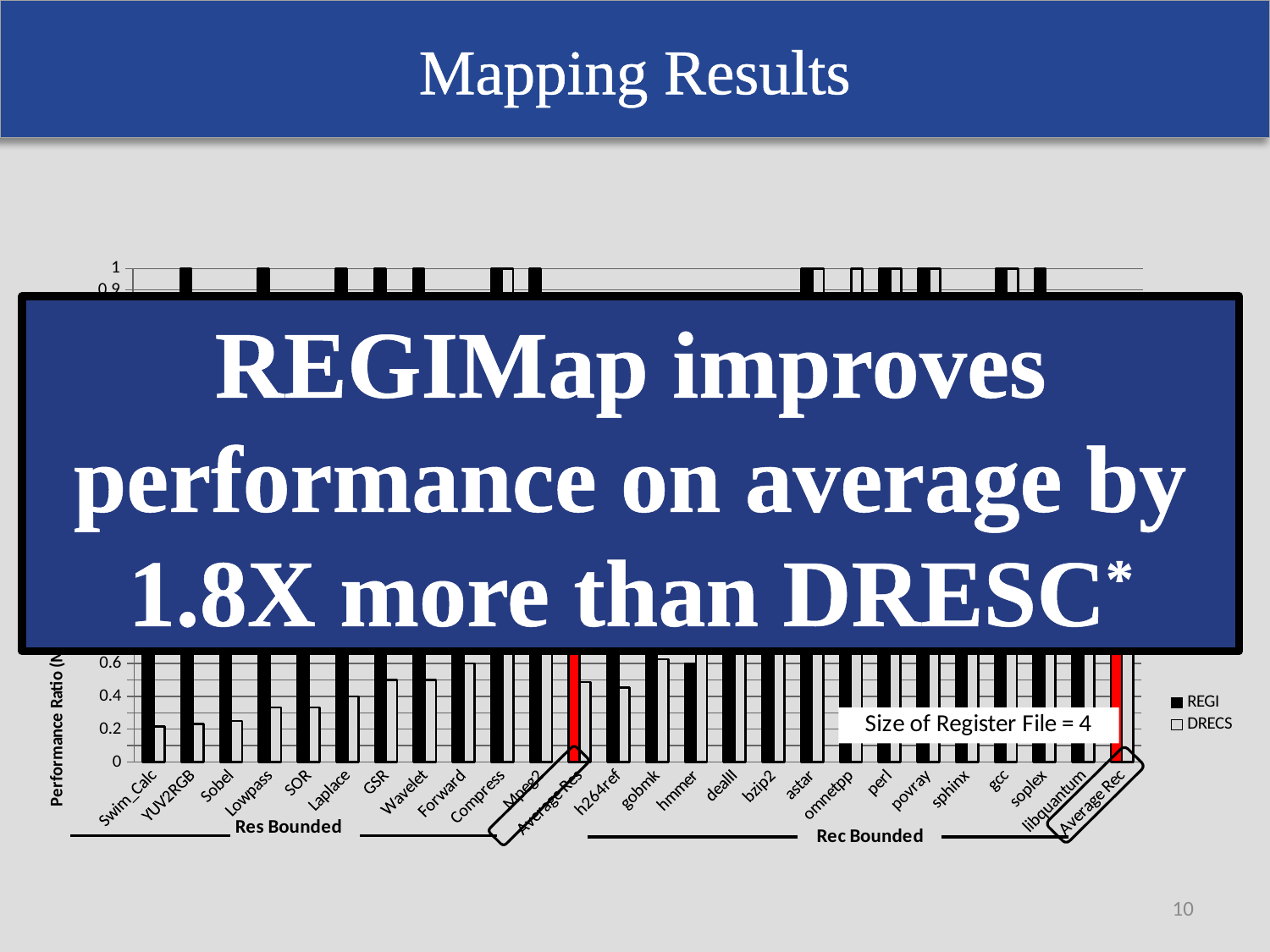
What kind of chart is shown on the slide? bar chart For Sobel, which series has the larger value, REGI or DRECS? REGI For Swim_Calc, which series has the larger value, REGI or DRECS? REGI Is the DRECS value for Lowpass greater or less than 0.6? less Which two groups are the categories on the x axis divided into? Res Bounded and Rec Bounded Is the DRECS value for Swim_Calc greater or less than 0.4? less How many series does the chart's legend list? 2 What register file size does the annotation on the chart state? Size of Register File = 4 What are the two series named in the chart's legend? REGI and DRECS How many categories are shown along the x axis of the chart? 26 Is the REGI value for Swim_Calc greater or less than 0.6? greater